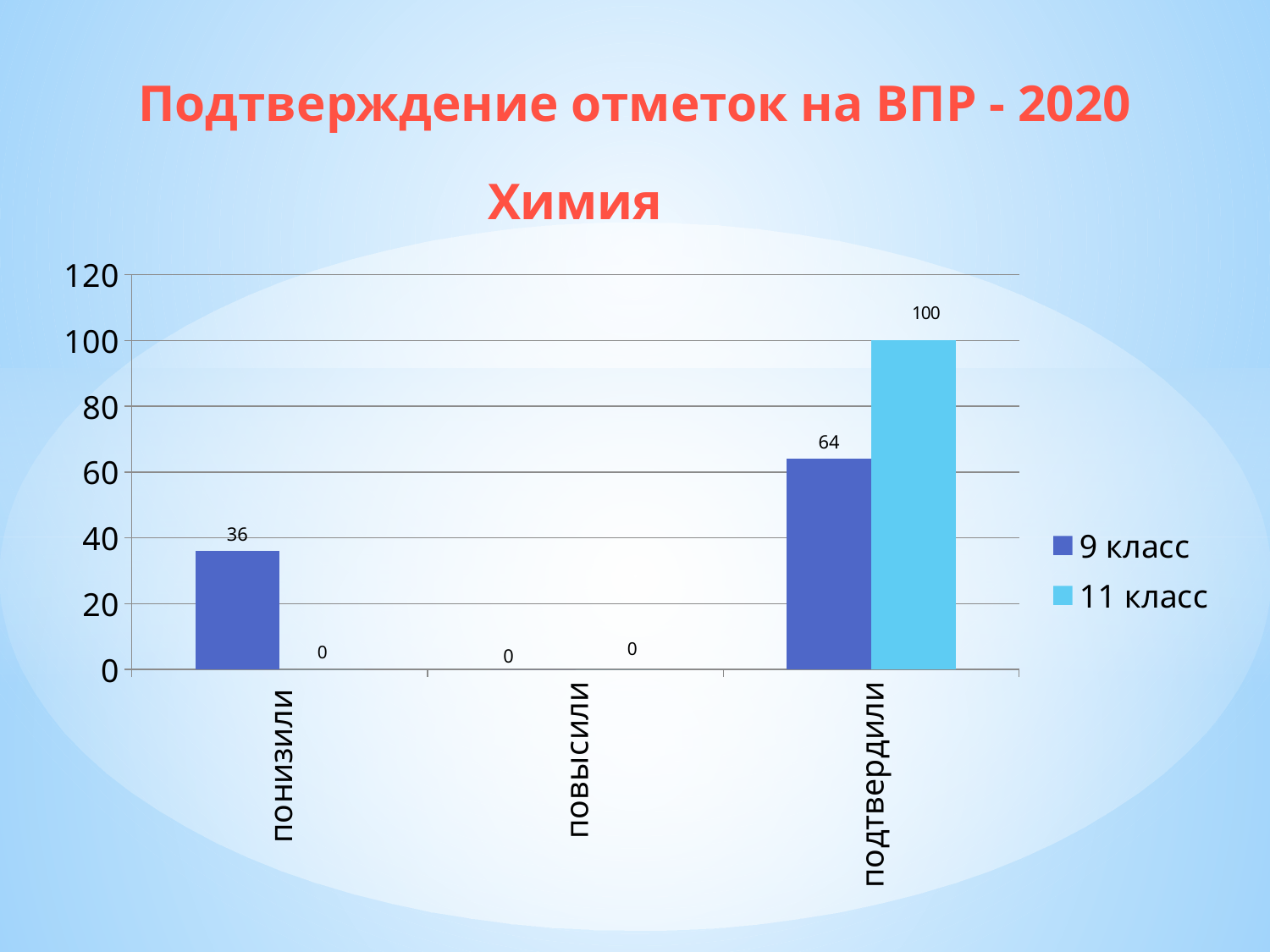
In the подтвердили category, which series has the larger value, 9 класс or 11 класс? 11 класс Which category has the highest value for 9 класс? подтвердили What kind of chart is shown on the slide? bar chart What is the difference between the 11 класс and 9 класс values in the подтвердили category? 36 What is the value for 9 класс in the подтвердили category? 64 What is the value for 11 класс in the понизили category? 0 How many series does the legend list? 2 How many categories are shown on the x axis? 3 Which category has the lowest value for 9 класс? повысили What is the value for 9 класс in the понизили category? 36 What is the value for 11 класс in the подтвердили category? 100